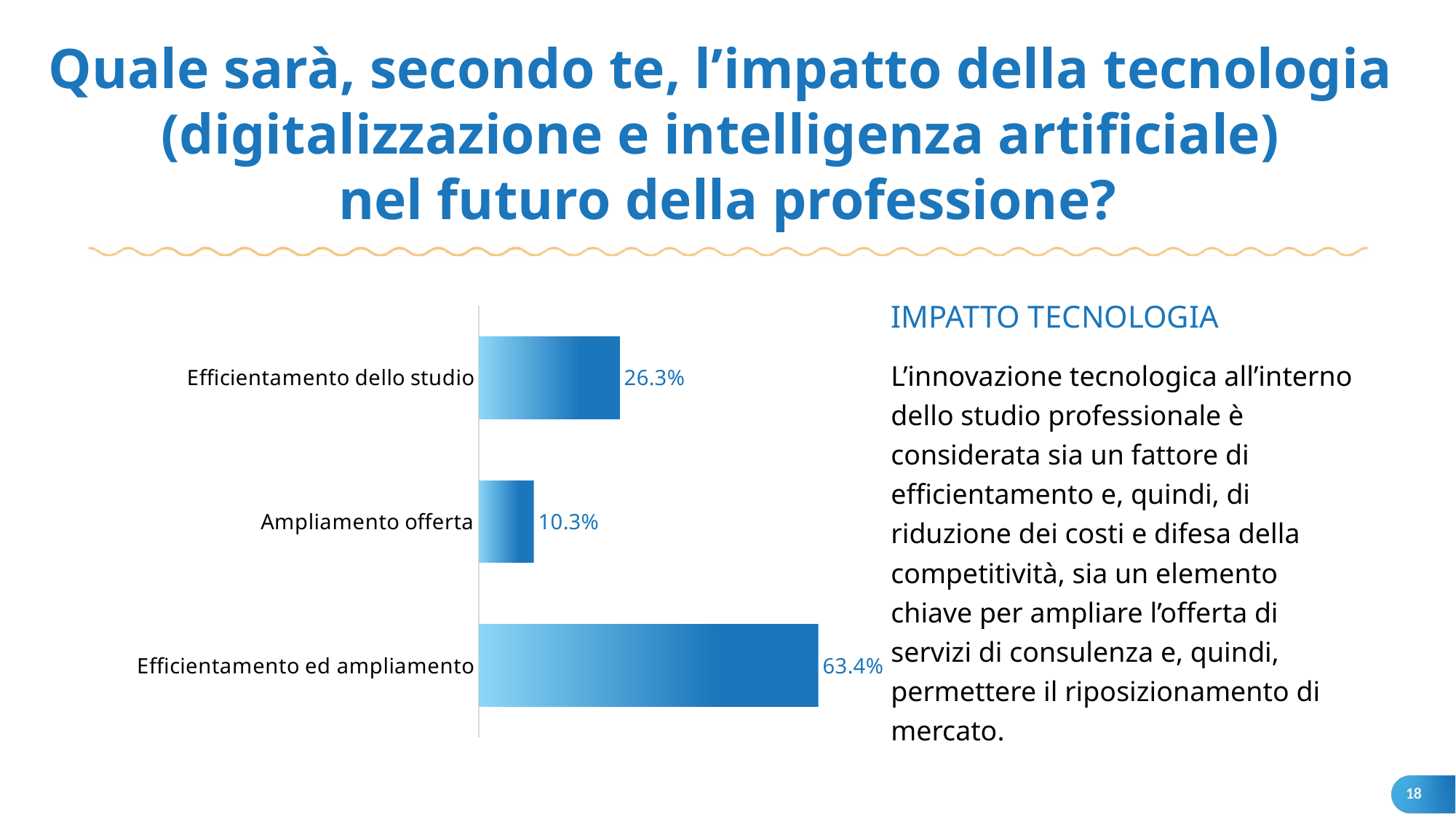
Which category has the highest value? Efficientamento ed ampliamento What is the difference between the values for "Efficientamento ed ampliamento" and "Efficientamento dello studio"? 37.1% Which is larger, the value for "Efficientamento dello studio" or the value for "Ampliamento offerta"? Efficientamento dello studio What kind of chart is shown on the slide? Bar chart How many categories are shown in the chart? 3 What is the total of the three values shown in the chart? 100.0% What is the heading of the text block to the right of the chart? IMPATTO TECNOLOGIA What is the difference between the values for "Efficientamento dello studio" and "Ampliamento offerta"? 16.0% What is the value for "Efficientamento ed ampliamento"? 63.4% What is the value for "Efficientamento dello studio"? 26.3% What is the value for "Ampliamento offerta"? 10.3% Which category has the lowest value? Ampliamento offerta